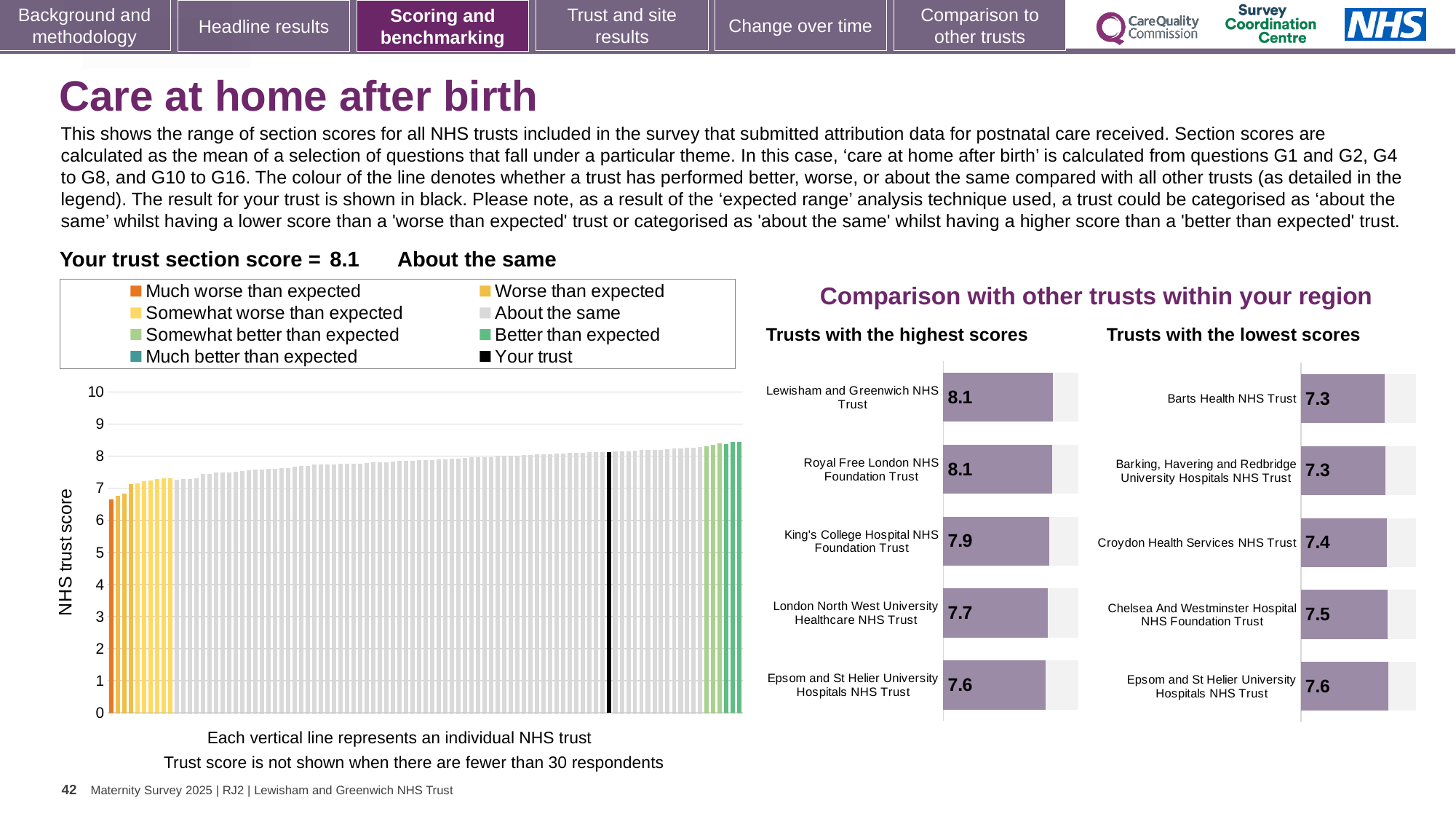
What kind of chart is the large chart on the left showing all NHS trusts? Bar chart In the large chart on the left, what is the section score for your trust (the black bar)? 8.1 In the large chart on the left, is the value of the lowest-scoring trust (leftmost bar) greater or less than 7? less In the 'Trusts with the lowest scores' chart, which trust has the highest score? Epsom and St Helier University Hospitals NHS Trust In the 'Trusts with the lowest scores' chart, what is the score for Croydon Health Services NHS Trust? 7.4 In the large chart on the left, do the trust scores rise or fall from left to right? Rise In the 'Trusts with the highest scores' chart, what is the score for King's College Hospital NHS Foundation Trust? 7.9 In the 'Trusts with the lowest scores' chart, which has the higher score: Chelsea And Westminster Hospital NHS Foundation Trust or Barts Health NHS Trust? Chelsea And Westminster Hospital NHS Foundation Trust What is the y-axis title of the large chart on the left? NHS trust score How many trusts are shown in the 'Trusts with the highest scores' chart? 5 How many entries does the legend above the large chart on the left list? 8 In the 'Trusts with the highest scores' chart, what is the difference between the scores of Lewisham and Greenwich NHS Trust and Epsom and St Helier University Hospitals NHS Trust? 0.5